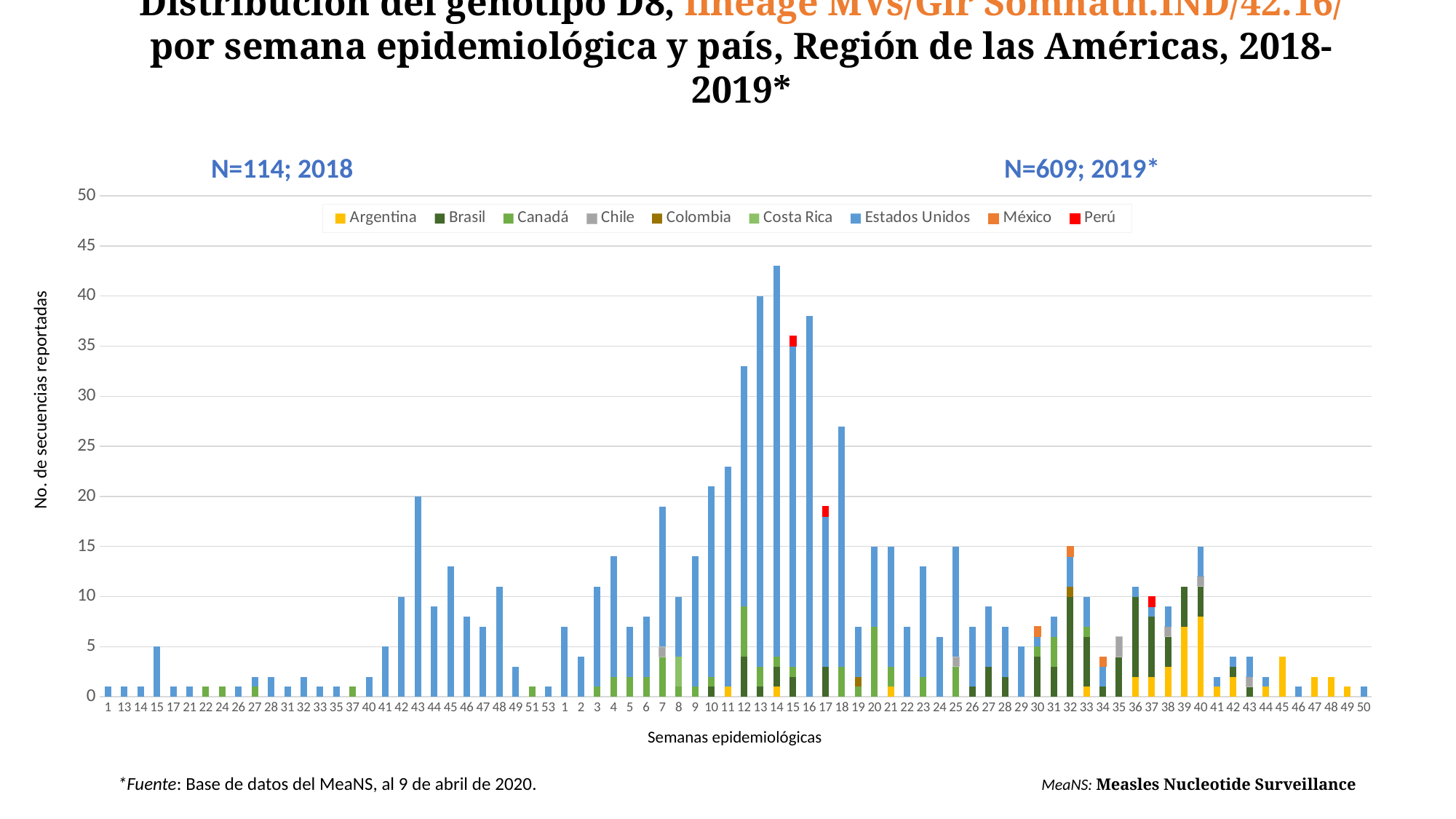
Is the value for week 16 of 2019 greater or less than 40? less Which is larger, the bar for week 13 of 2019 or the bar for week 43 of 2018? Week 13 of 2019 Which country is shown in yellow in the legend? Argentina What kind of chart is shown on the slide? Stacked bar chart Which epidemiological week has the highest number of reported sequences? Week 14 of 2019 Is the value for week 18 of 2019 greater or less than 25? greater How many countries (series) does the legend list? 9 Is the value for week 12 of 2019 greater or less than 30? greater What is the total number of sequences reported for 2018 according to the annotation on the chart? N=114 Which country accounts for most of the reported sequences in the tallest bars of 2019? Estados Unidos